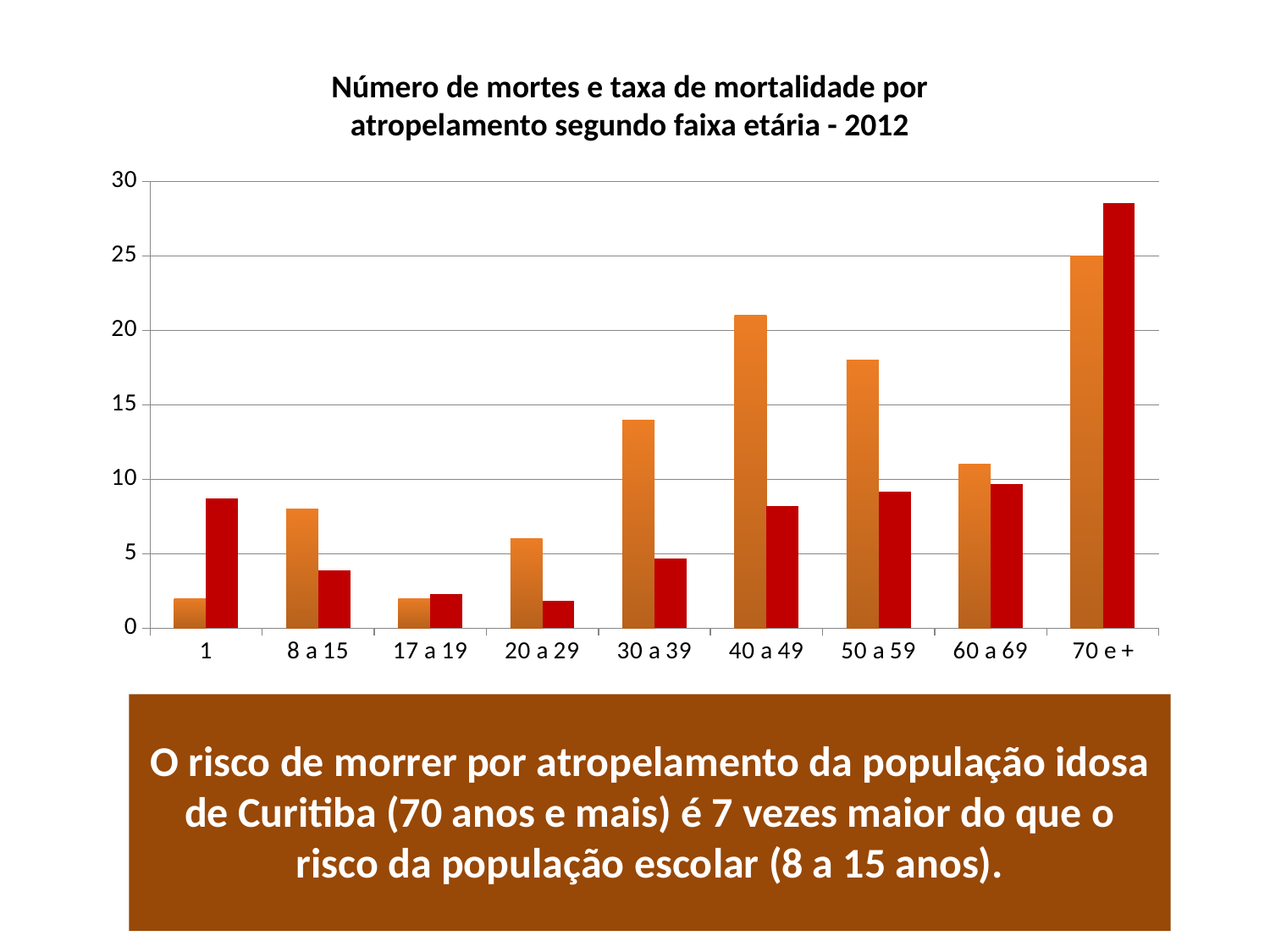
For the 40 a 49 age group, which bar is taller, the orange one or the red one? orange How many data series (bars per category) are plotted in the chart? 2 Which age group has the tallest red bar? 70 e + What is the value of the orange bar for the 70 e + age group? 25 How many age-group categories are shown on the x axis? 9 What kind of chart is shown on the slide? bar chart Is the orange bar for the 30 a 39 age group greater or less than 15? less Is the red bar for the 70 e + age group greater or less than 25? greater What is the title of the chart? Número de mortes e taxa de mortalidade por atropelamento segundo faixa etária - 2012 For the age group 1, which bar is taller, the orange one or the red one? red Is the orange bar for the 40 a 49 age group greater or less than 20? greater Which age group has the tallest orange bar? 70 e +